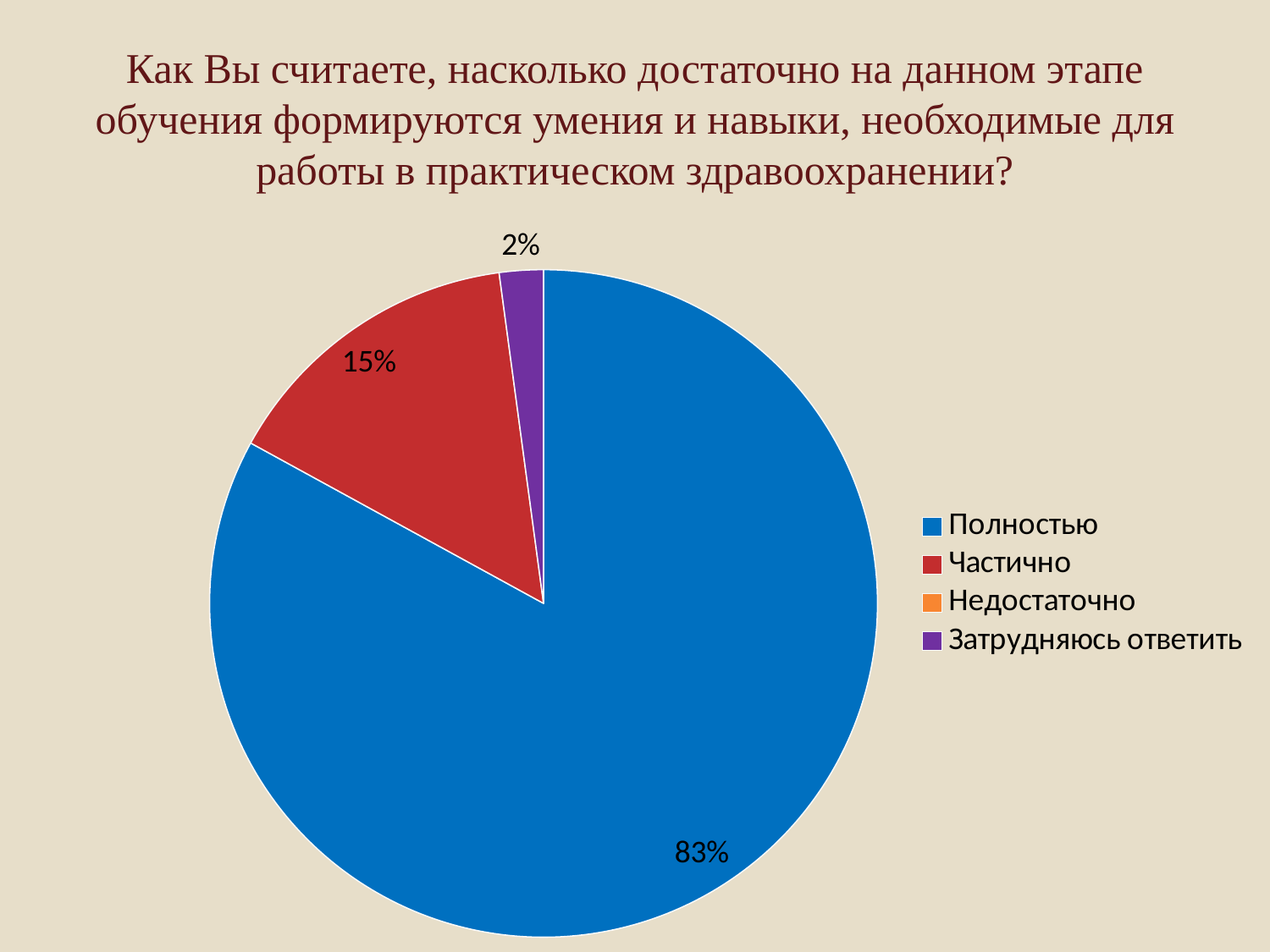
What is the difference in percentage points between "Полностью" and "Частично"? 68 Which is larger, the slice for "Частично" or the slice for "Затрудняюсь ответить"? Частично Which legend entry is shown in purple? Затрудняюсь ответить How many entries does the legend list? 4 What share of the pie does "Частично" take? 15% What share of the pie does "Полностью" take? 83% What is the difference in percentage points between "Частично" and "Затрудняюсь ответить"? 13 Which of the labelled slices is the smallest? Затрудняюсь ответить What colour is the slice for "Полностью"? blue What share of the pie does "Затрудняюсь ответить" take? 2% Which category has the largest slice of the pie? Полностью What kind of chart is shown on the slide? pie chart